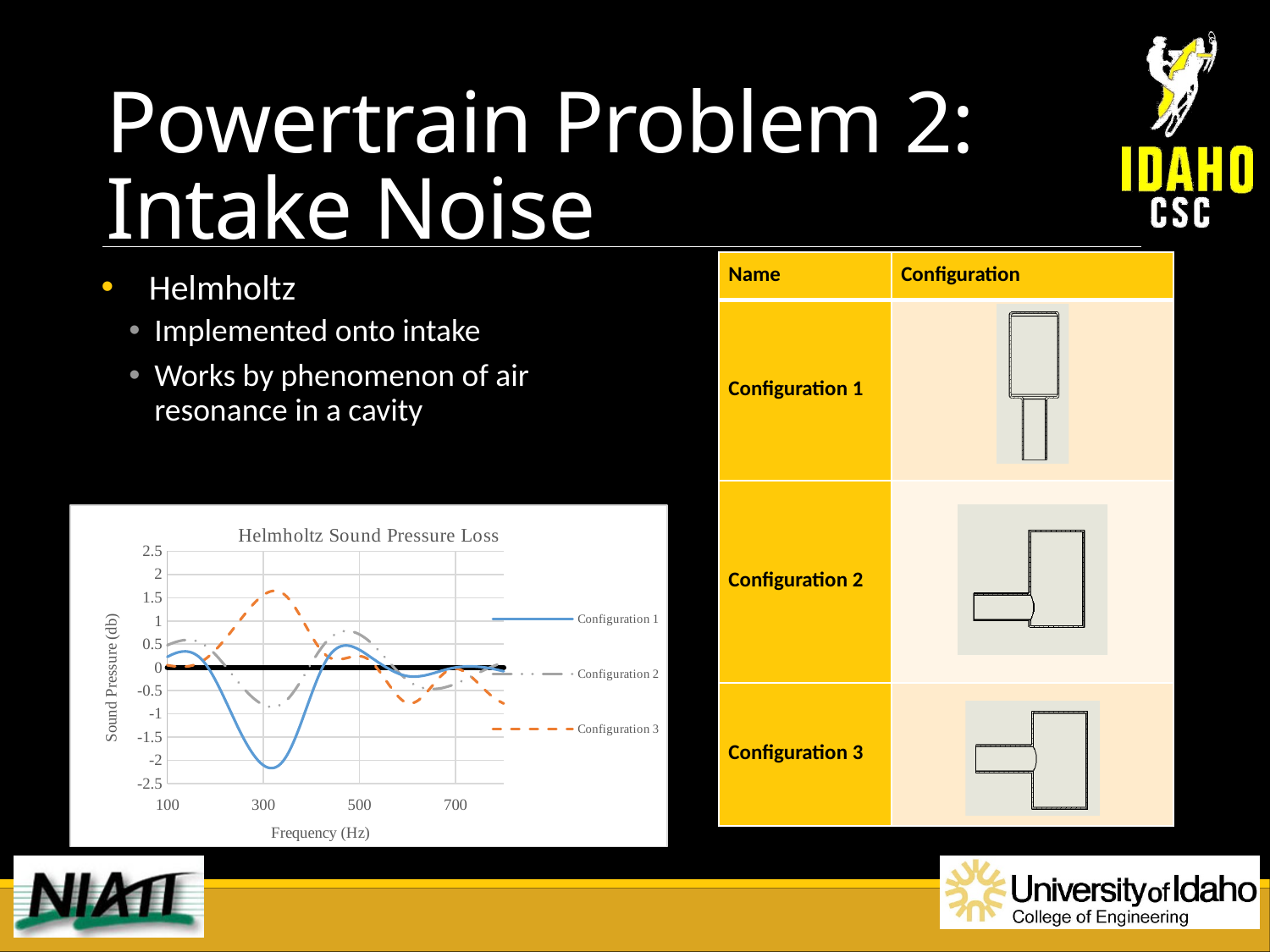
How many series does the legend of the Helmholtz Sound Pressure Loss chart list? 3 In the Helmholtz Sound Pressure Loss chart, which has the higher value at 300 Hz, Configuration 1 or Configuration 3? Configuration 3 In the Helmholtz Sound Pressure Loss chart, which configuration reaches the highest sound pressure value? Configuration 3 In the Helmholtz Sound Pressure Loss chart, is the value for Configuration 3 at 300 Hz greater or less than 1? greater What is the label of the x axis of the Helmholtz Sound Pressure Loss chart? Frequency (Hz) In the Helmholtz Sound Pressure Loss chart, is the value for Configuration 1 at 300 Hz greater or less than -1? less In the Helmholtz Sound Pressure Loss chart, which configuration reaches the lowest sound pressure value? Configuration 1 What is the title of the chart on the slide? Helmholtz Sound Pressure Loss In the Helmholtz Sound Pressure Loss chart, does the Configuration 1 line rise or fall between 300 Hz and 500 Hz? rise In the Helmholtz Sound Pressure Loss chart, does the Configuration 3 line rise or fall between 100 Hz and 300 Hz? rise What kind of chart is the Helmholtz Sound Pressure Loss chart? line chart In the Helmholtz Sound Pressure Loss chart, is the value for Configuration 2 at 300 Hz greater or less than 0? less